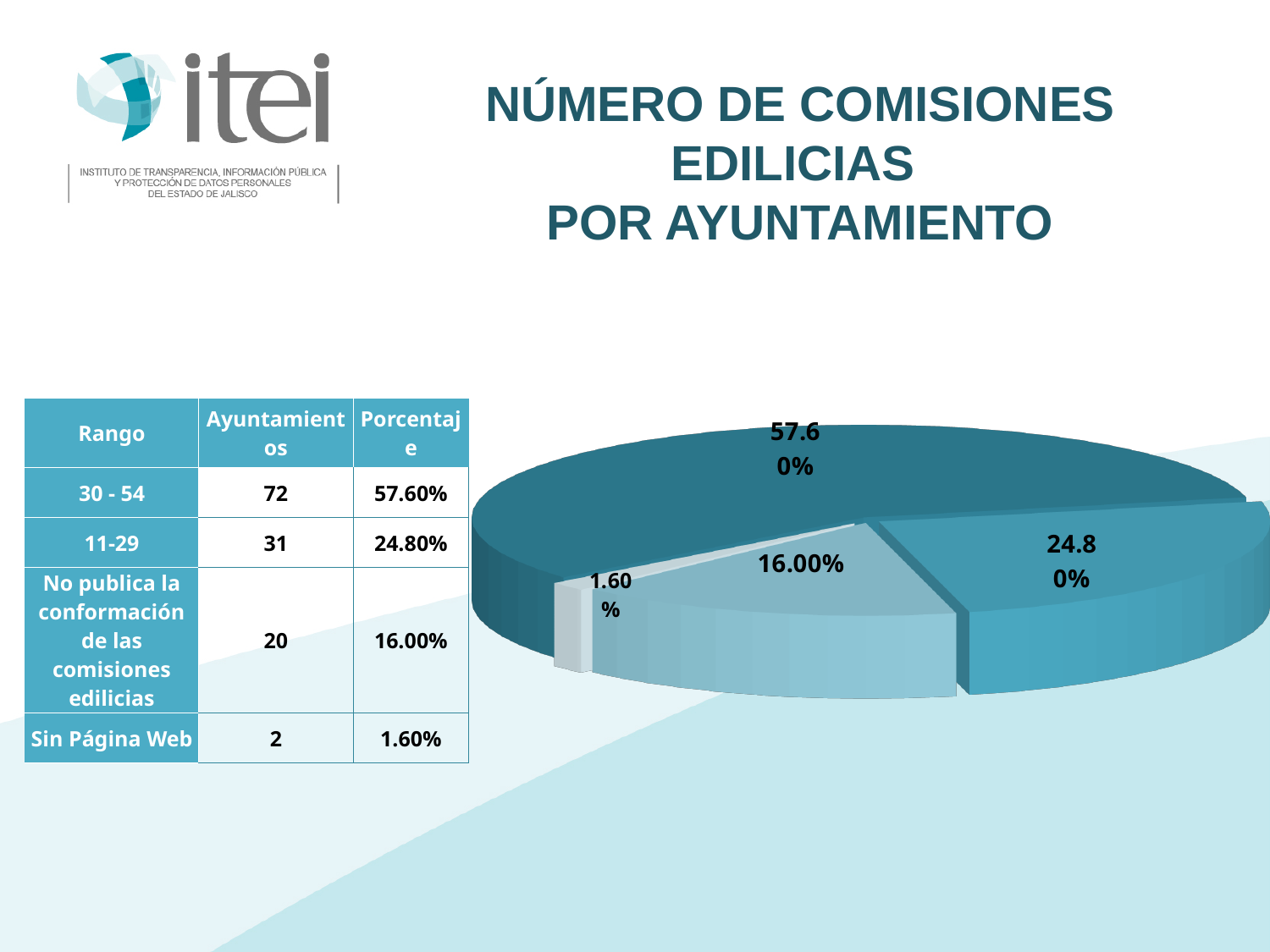
What is the largest percentage shown on the pie chart? 57.60% According to the table, how many ayuntamientos fall in the range 11-29? 31 Which is larger: the slice for 11-29 or the slice for 'No publica la conformación de las comisiones edilicias'? 11-29 What kind of chart is shown on the slide? pie chart What is the smallest percentage shown on the pie chart? 1.60% What is the difference in percentage points between the 57.60% slice and the 24.80% slice? 32.80% How many ayuntamientos are in the range 30 - 54 according to the table? 72 How many slices does the pie chart have? 4 What share of the pie corresponds to 'No publica la conformación de las comisiones edilicias'? 16.00% What is the title of the slide containing the pie chart? NÚMERO DE COMISIONES EDILICIAS POR AYUNTAMIENTO According to the table, what percentage corresponds to the range 30 - 54? 57.60% What share of the pie corresponds to 'Sin Página Web'? 1.60%